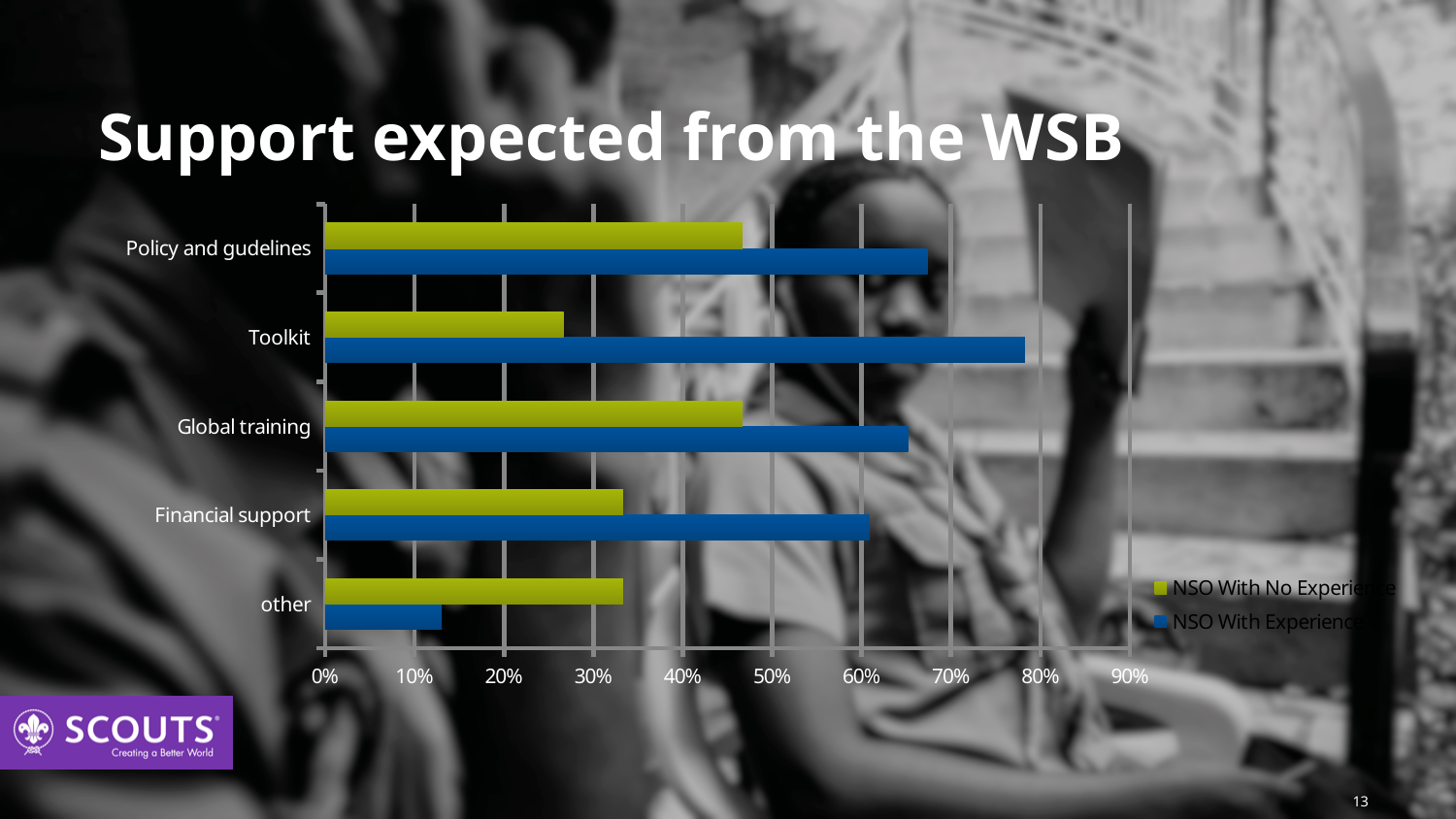
What is the title of the slide? Support expected from the WSB How many series does the legend list? 2 Is the value for Toolkit for NSO With No Experience greater or less than 30%? less Which category has the lowest value for NSO With No Experience? Toolkit Is the value for other for NSO With Experience greater or less than 20%? less What kind of chart is shown on the slide? bar chart Which category has the highest value for NSO With Experience? Toolkit For Financial support, which series has the larger value, NSO With No Experience or NSO With Experience? NSO With Experience For the category other, which series has the larger value, NSO With No Experience or NSO With Experience? NSO With No Experience Is the value for Toolkit for NSO With Experience greater or less than 70%? greater How many categories are shown on the chart? 5 Which category has the lowest value for NSO With Experience? other